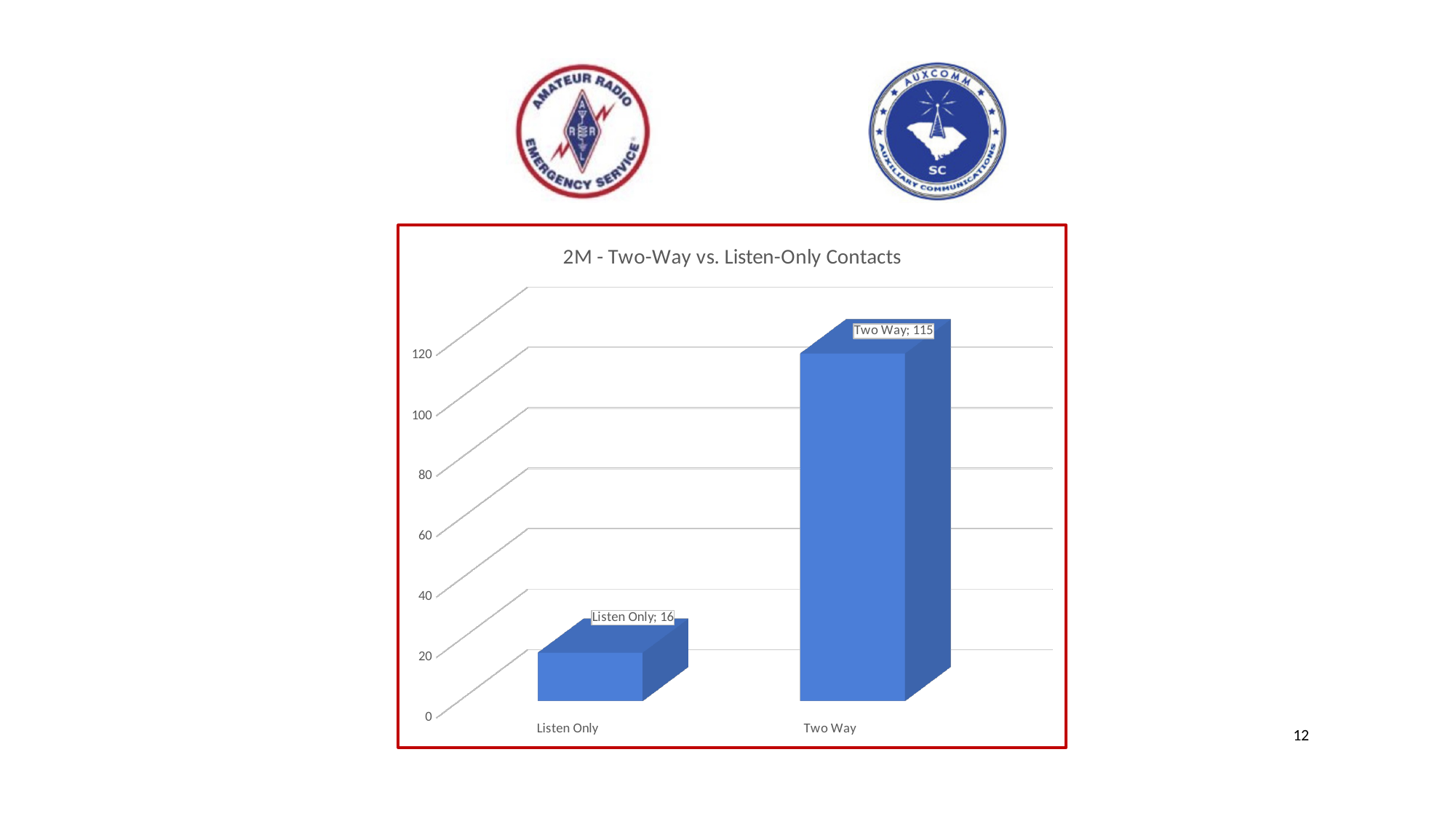
What is the title of the chart? 2M - Two-Way vs. Listen-Only Contacts How many categories are shown on the chart? 2 What is the value for Listen Only? 16 What is the total of the Listen Only and Two Way values? 131 What is the difference between the Two Way and Listen Only values? 99 What is the value for Two Way? 115 Is the value for Listen Only greater or less than 20? less Is the value for Two Way greater or less than 100? greater What kind of chart is shown on the slide? bar chart Which is larger, Listen Only or Two Way? Two Way Which category has the lowest value? Listen Only Which category has the highest value? Two Way